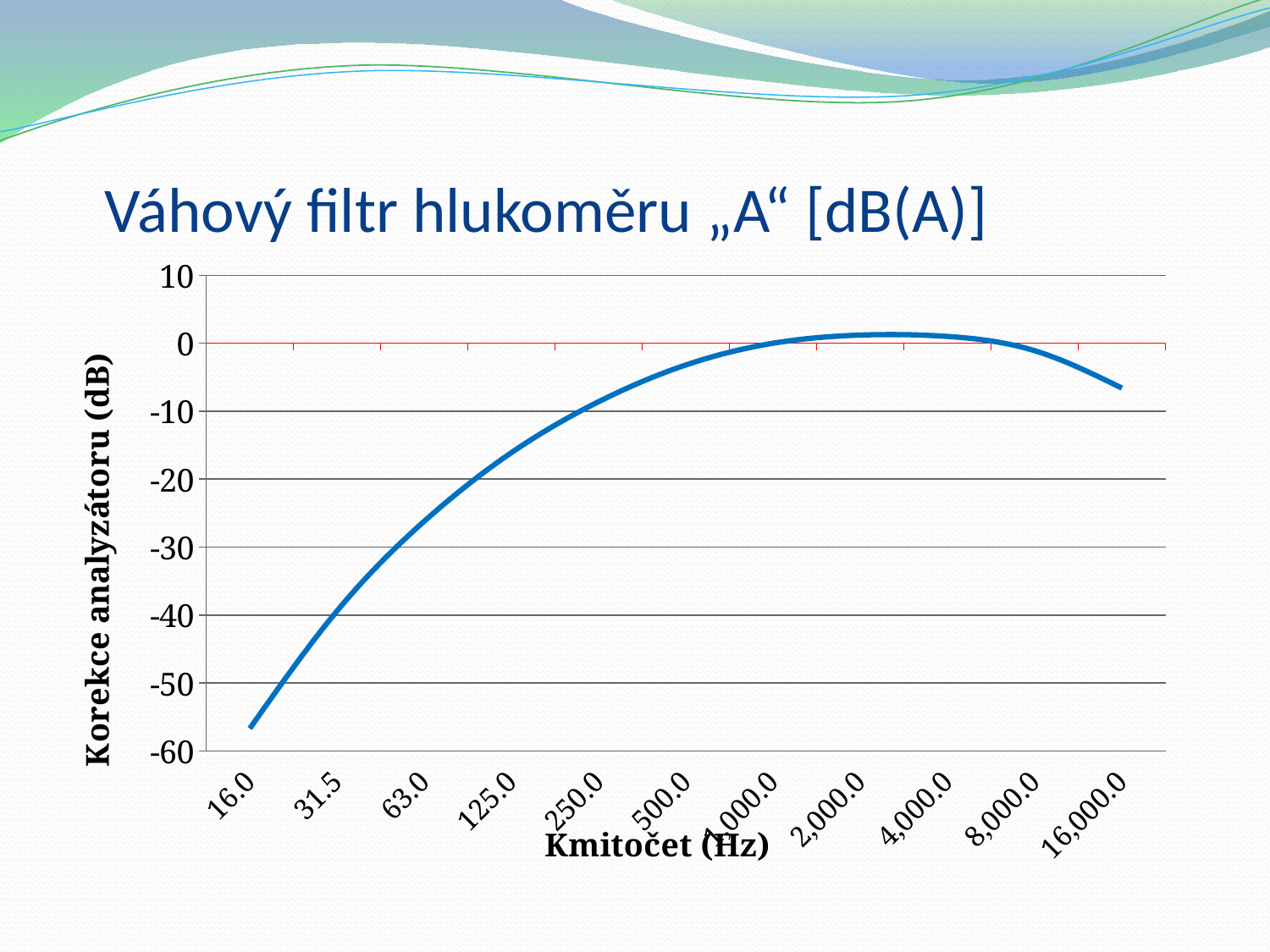
What is the title of the y axis? Korekce analyzátoru (dB) Is the value at 63.0 Hz greater or less than -20? less What kind of chart is shown on the slide? line chart Is the value at 16,000.0 Hz greater or less than 0? less Which has the larger correction value, 16.0 Hz or 16,000.0 Hz? 16,000.0 How many frequency categories are labelled on the x axis? 11 At which frequency is the correction value lowest? 16.0 Does the curve rise or fall between 16.0 Hz and 1,000.0 Hz? rise Is the value at 500.0 Hz greater or less than -10? greater